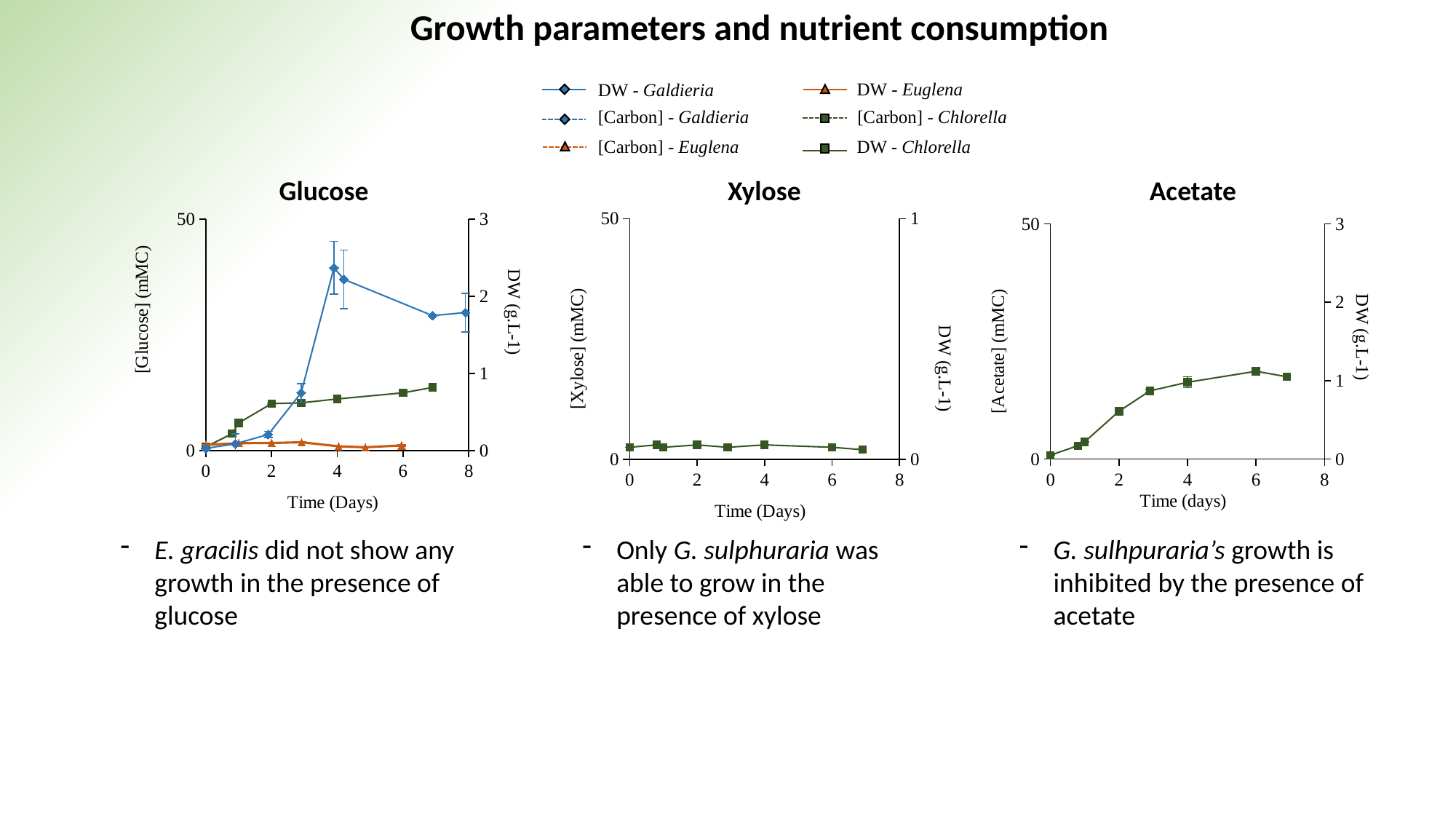
In the Glucose chart, is the DW - Galdieria value at day 4 greater or less than 2 on the right-hand DW axis? greater How many data points are plotted in the Xylose chart? 8 In the Glucose chart, is the DW - Chlorella value at day 7 greater or less than 1 on the right-hand DW axis? less In the Glucose chart, which series reaches the highest dry weight (DW) value? DW - Galdieria In the Glucose chart, at which day does the DW - Galdieria series reach its peak? Day 4 In the Acetate chart, is the value at day 2 greater or less than 1 on the right-hand DW axis? less In the Acetate chart, do the plotted values generally rise or fall from day 0 to day 6? Rise In the Glucose chart, which series stays lowest across all days? DW - Euglena How many series does the shared legend above the charts list? 6 What kind of chart is the Glucose chart? Line chart In the Glucose chart, at day 4, which series has the larger value: DW - Galdieria or DW - Chlorella? DW - Galdieria What is the label of the right-hand y-axis of the Acetate chart? DW (g.L-1)